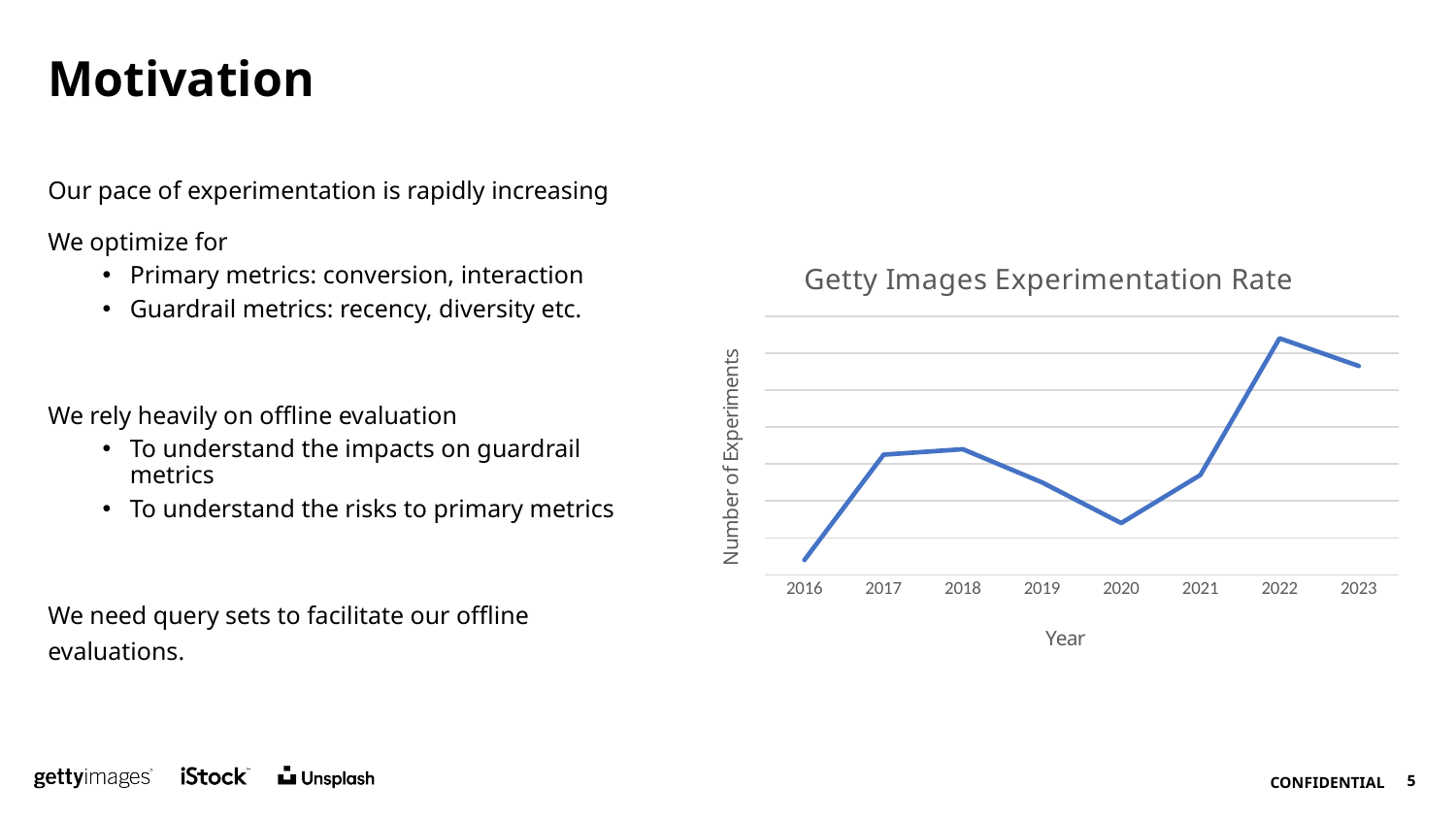
Which year has more experiments, 2018 or 2020? 2018 How many years are plotted on the x axis of the chart? 8 Which year has the lowest number of experiments? 2016 Does the number of experiments rise or fall from 2018 to 2020? Fall What kind of chart is shown on the slide? Line chart Does the number of experiments rise or fall from 2016 to 2017? Rise Does the number of experiments rise or fall from 2020 to 2022? Rise What is the label on the vertical axis of the chart? Number of Experiments Which year has more experiments, 2016 or 2021? 2021 What is the title of the chart? Getty Images Experimentation Rate Which year has the highest number of experiments? 2022 Which year has more experiments, 2022 or 2023? 2022